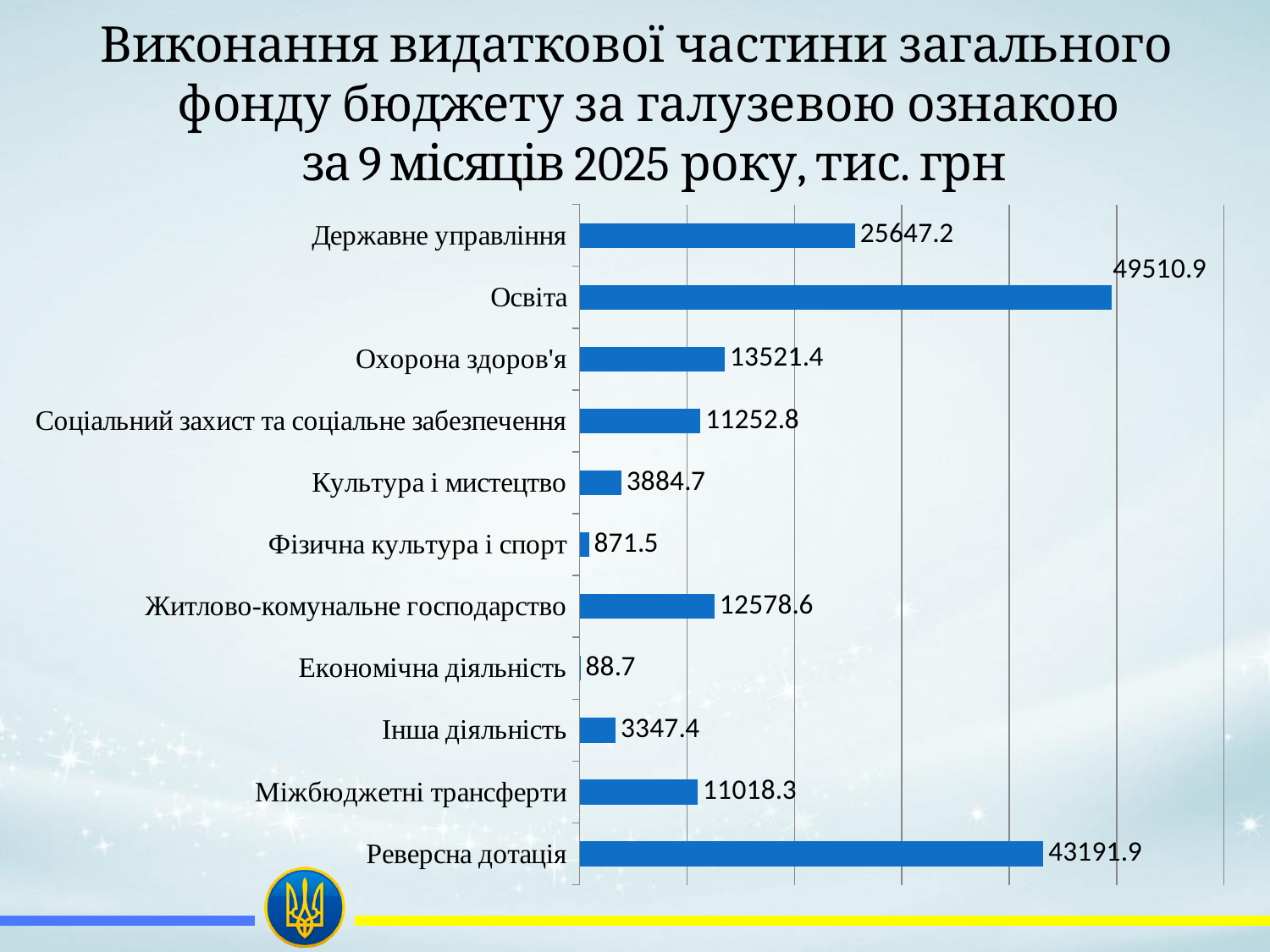
Which category has the lowest value? Економічна діяльність What is the value for Міжбюджетні трансферти? 11018.3 What is the value for Фізична культура і спорт? 871.5 What kind of chart is shown on the slide? Bar chart Which category has the highest value? Освіта What is the difference between the values for Освіта and Реверсна дотація? 6319.0 Which is larger, the value for Культура і мистецтво or the value for Інша діяльність? Культура і мистецтво Which is larger, the value for Охорона здоров'я or the value for Житлово-комунальне господарство? Охорона здоров'я How many categories are shown in the chart? 11 What is the value for Реверсна дотація? 43191.9 What is the value for Освіта? 49510.9 What is the difference between the values for Державне управління and Охорона здоров'я? 12125.8